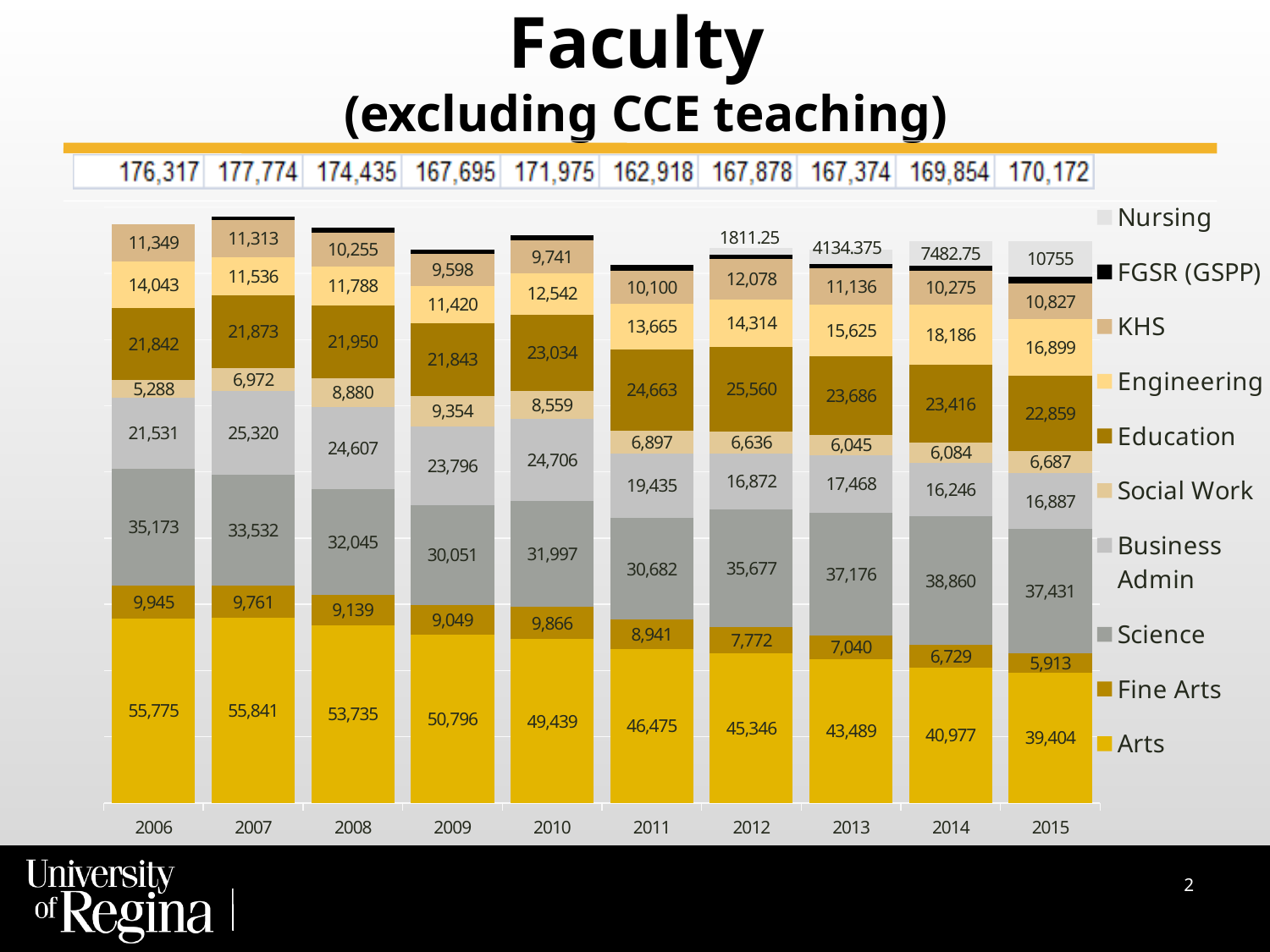
What is the difference between the Arts value in 2006 and the Arts value in 2015? 16,371 Does the Arts value rise or fall from 2006 to 2015? Fall In which year is the Fine Arts value lowest? 2015 What is the total shown for the 2011 bar? 162,918 How many series does the legend list? 10 In which year is the Science value highest? 2014 What is the value for Arts in 2015? 39,404 What is the value for Education in 2012? 25,560 In 2014, which is larger: the Science value or the Education value? Science What is the value for Science in 2013? 37,176 What kind of chart is shown on the slide? Stacked bar chart How many years are shown on the x axis? 10